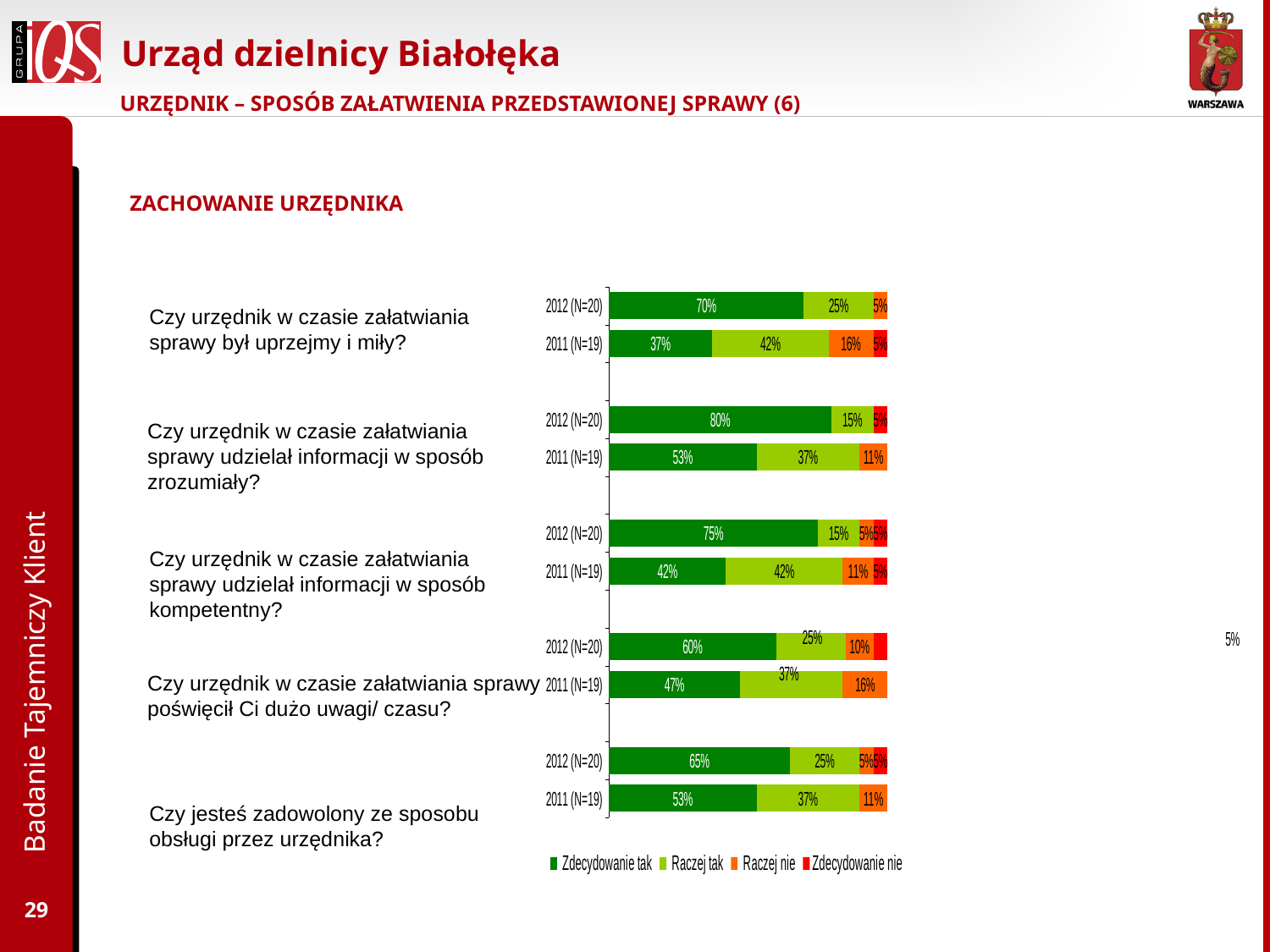
What is the 'Zdecydowanie tak' value for 2012 (N=20) for the question 'Czy urzędnik w czasie załatwiania sprawy udzielał informacji w sposób zrozumiały?' 80% What is the 'Raczej nie' value for 2011 (N=19) for the question 'Czy urzędnik w czasie załatwiania sprawy poświęcił Ci dużo uwagi/ czasu?' 16% What is the difference between the 'Zdecydowanie tak' values for 2012 (N=20) and 2011 (N=19) for the question 'Czy urzędnik w czasie załatwiania sprawy udzielał informacji w sposób kompetentny?' 33 percentage points How many series does the chart legend list? 4 Which bar has the highest 'Zdecydowanie tak' value across all questions and years? 2012 (N=20) for 'Czy urzędnik w czasie załatwiania sprawy udzielał informacji w sposób zrozumiały?' For the question 'Czy jesteś zadowolony ze sposobu obsługi przez urzędnika?', which year has the larger 'Zdecydowanie tak' value, 2012 (N=20) or 2011 (N=19)? 2012 (N=20) How many bars are plotted in the chart? 10 What is the difference between the 'Zdecydowanie tak' values for 2012 (N=20) and 2011 (N=19) for the question 'Czy urzędnik w czasie załatwiania sprawy był uprzejmy i miły?' 33 percentage points What is the 'Zdecydowanie tak' value for 2012 (N=20) for the question 'Czy urzędnik w czasie załatwiania sprawy był uprzejmy i miły?' 70% What type of chart is shown on the slide? stacked bar chart What is the 'Raczej tak' value for 2011 (N=19) for the question 'Czy urzędnik w czasie załatwiania sprawy był uprzejmy i miły?' 42% Which legend entry is shown in red? Zdecydowanie nie